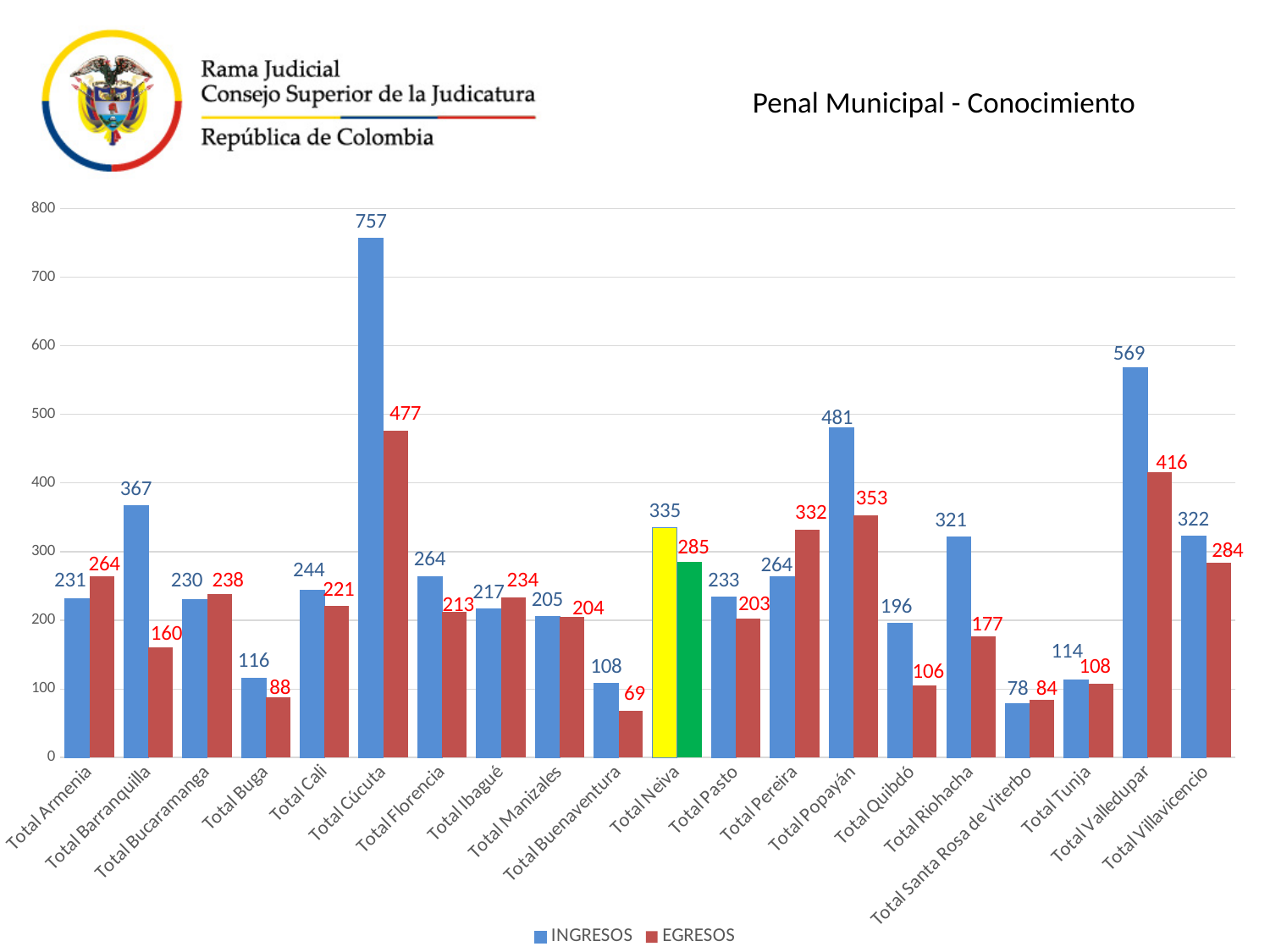
How many categories are shown on the x axis? 20 What is the EGRESOS value for Total Neiva? 285 Is the INGRESOS value for Total Popayán greater or less than 400? greater What is the difference between INGRESOS and EGRESOS for Total Valledupar? 153 What kind of chart is shown on the slide? bar chart Which category has the lowest EGRESOS value? Total Buenaventura Which is larger for Total Armenia, INGRESOS or EGRESOS? EGRESOS What is the INGRESOS value for Total Cúcuta? 757 How many series does the legend list? 2 What is the title of the chart? Penal Municipal - Conocimiento Which category has the highest INGRESOS value? Total Cúcuta What is the EGRESOS value for Total Santa Rosa de Viterbo? 84